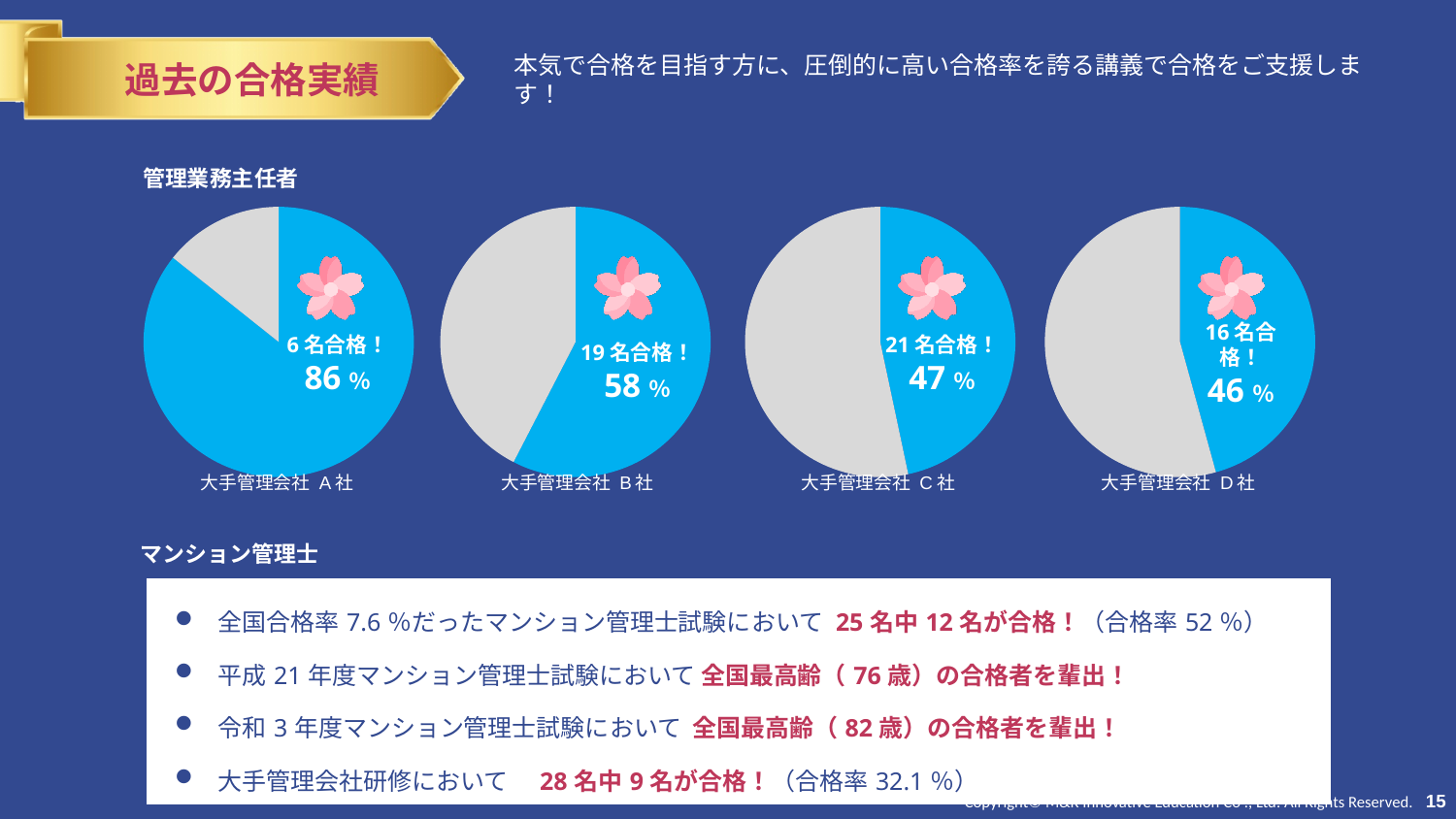
How many more people passed in the 大手管理会社 C社 pie chart than in the 大手管理会社 D社 pie chart? 5名 In the pie chart for 大手管理会社 D社, how many people passed? 16名 What kind of chart is used to show the pass rates for the four companies? Pie chart How many pie charts are shown under the 管理業務主任者 heading? 4 In the pie chart for 大手管理会社 B社, how many people passed? 19名 What heading appears above the four pie charts? 管理業務主任者 In the pie chart for 大手管理会社 A社, what pass rate is shown? 86% Among the four pie charts under 管理業務主任者, which company has the highest pass rate? 大手管理会社 A社 Among the four pie charts under 管理業務主任者, which company has the lowest pass rate? 大手管理会社 D社 In the pie chart for 大手管理会社 C社, what share of the pie does the blue slice represent? 47% What is the difference in pass rate between the 大手管理会社 A社 pie chart and the 大手管理会社 B社 pie chart? 28% Which has the higher pass rate, the 大手管理会社 B社 pie chart or the 大手管理会社 C社 pie chart? 大手管理会社 B社